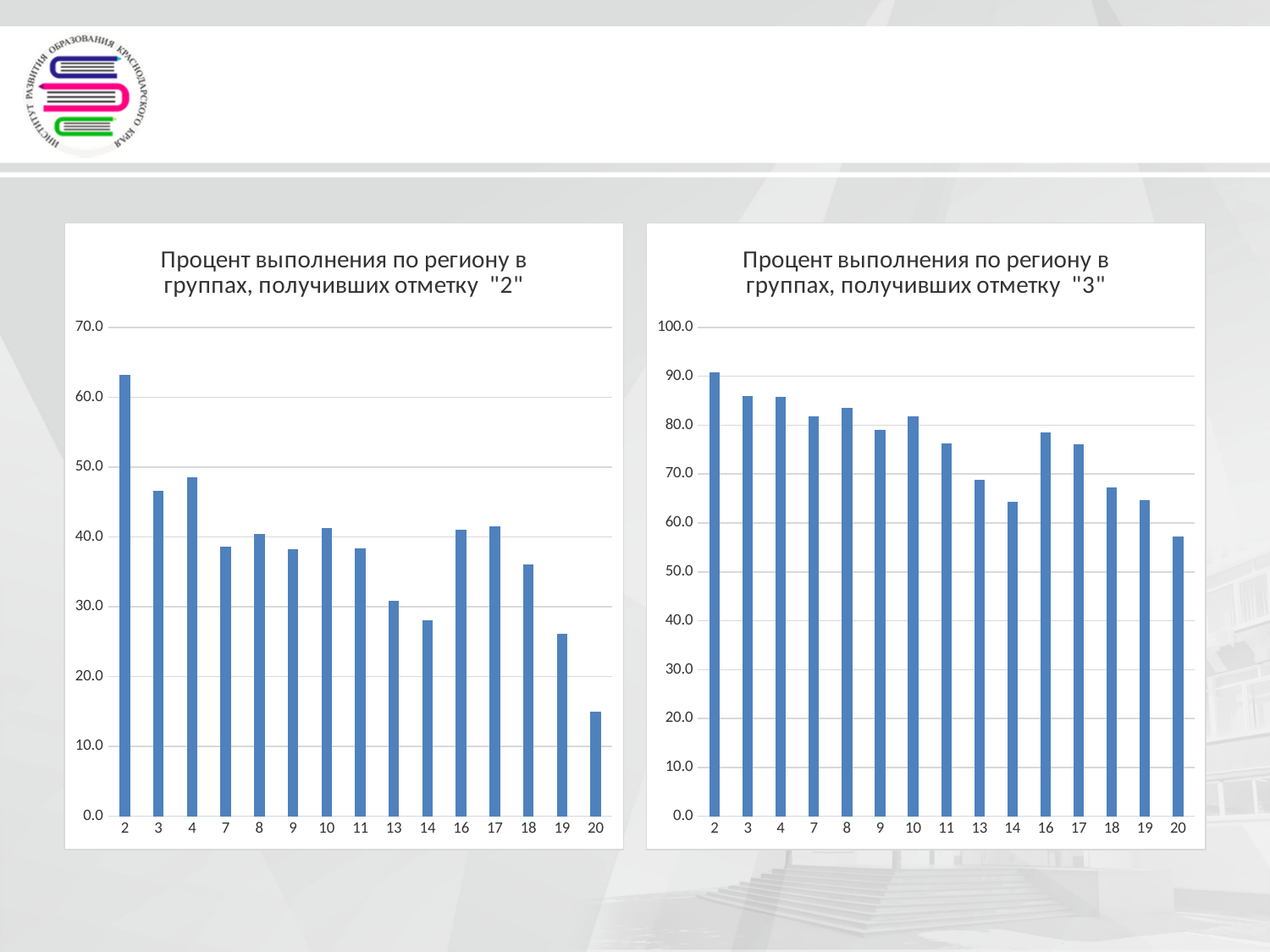
In the left chart (отметка "2"), which category has the highest bar? 2 In the right chart (отметка "3"), is the value for category 3 greater or less than 80.0? greater In the right chart (отметка "3"), which category has the lowest bar? 20 In the left chart (отметка "2"), which is larger, the value for category 13 or category 14? 13 In the left chart (отметка "2"), how many categories are shown on the x axis? 15 What kind of chart is the left chart, titled "Процент выполнения по региону в группах, получивших отметку "2""? bar chart In the left chart (отметка "2"), which category has the lowest bar? 20 In the right chart (отметка "3"), is the value for category 20 greater or less than 60.0? less In the right chart (отметка "3"), which category has the highest bar? 2 In the left chart (отметка "2"), is the value for category 2 greater or less than 60.0? greater In the right chart (отметка "3"), do the values generally rise or fall from category 2 to category 20? fall